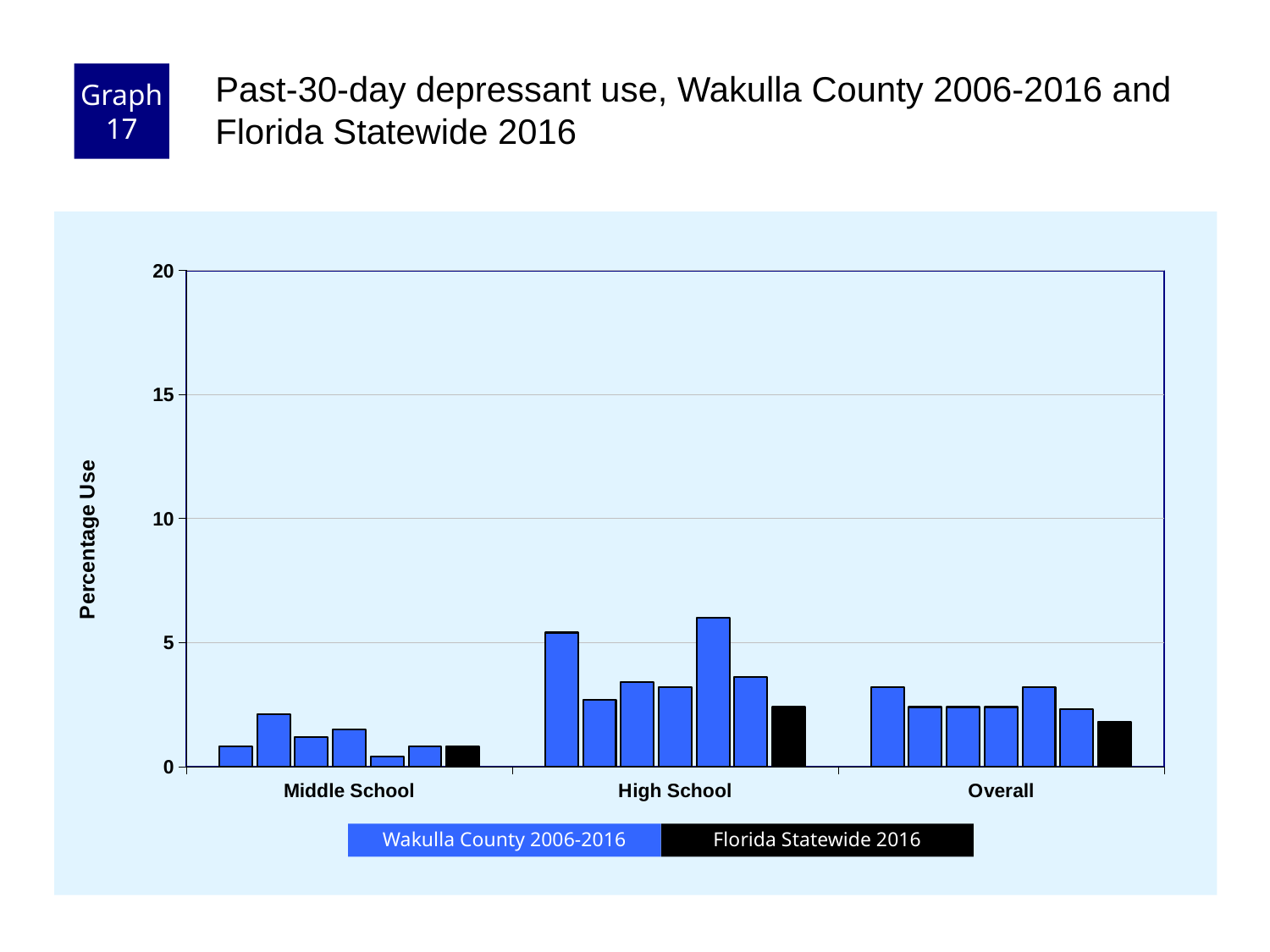
Are all the Middle School bars greater or less than 5? less What is the label on the y axis? Percentage Use How many categories are shown along the x axis? 3 Which is larger, the Florida Statewide 2016 bar for High School or the Florida Statewide 2016 bar for Middle School? High School Is the tallest Wakulla County bar in the High School group greater or less than 5? greater How many series does the legend list? 2 What colour represents Florida Statewide 2016 in the legend? black Is the Florida Statewide 2016 value for Middle School greater or less than 5? less Which category contains the tallest bar in the chart? High School What kind of chart is shown on the slide? bar chart Which category contains the shortest bar in the chart? Middle School